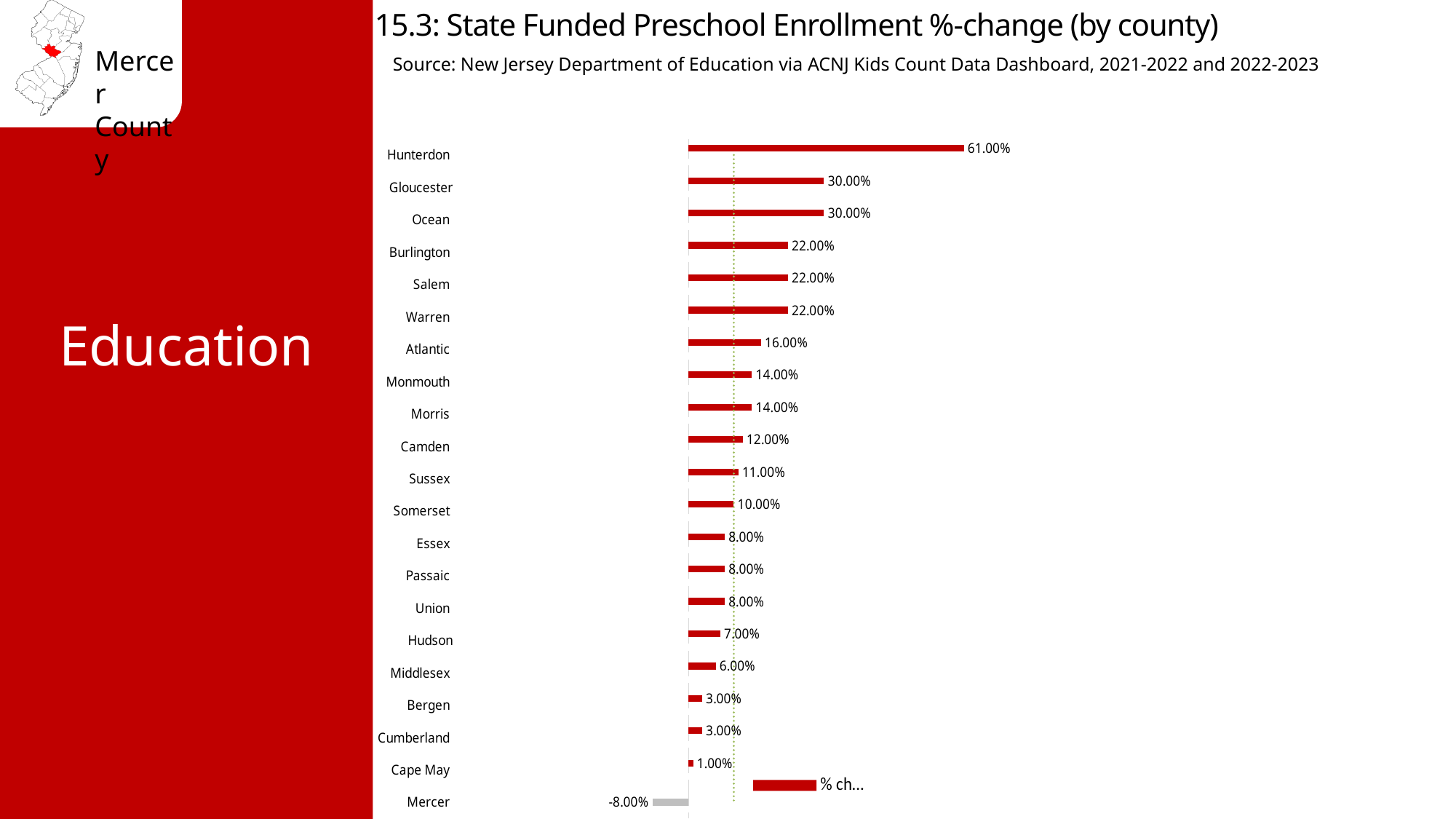
What is the value shown for Mercer? -8.00% Which county has the highest %-change? Hunterdon What is the difference between the values for Hunterdon and Gloucester? 31.00% Which county has the lowest %-change? Mercer What kind of chart is shown on the slide? Bar chart What is the difference between the values for Burlington and Camden? 10.00% What is the value shown for Cape May? 1.00% How many counties are shown in the chart? 21 Which has a larger value, Middlesex or Somerset? Somerset Which has a larger value, Ocean or Warren? Ocean What is the state funded preschool enrollment %-change for Hunterdon? 61.00% What is the value shown for Atlantic? 16.00%